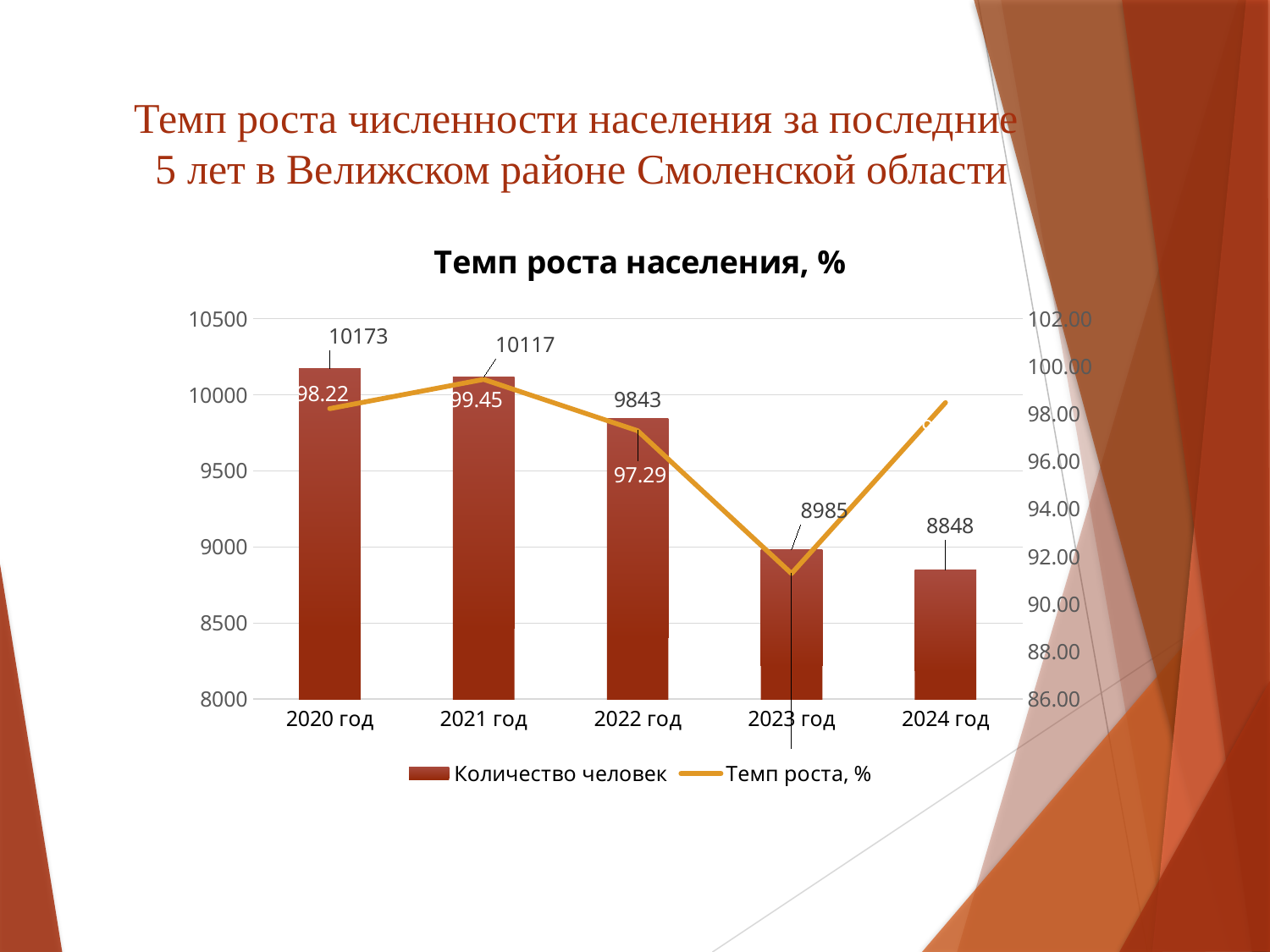
Does Количество человек rise or fall from 2020 год to 2024 год? fall Which year has the lowest value of Количество человек? 2024 год How many years are shown on the x axis? 5 What is the value of Количество человек for 2020 год? 10173 What is the value of Темп роста, % for 2022 год? 97.29 Is the value of Темп роста, % for 2023 год greater or less than 94.00? less What is the value of Темп роста, % for 2021 год? 99.45 Which year has the highest value of Количество человек? 2020 год Which is larger, Количество человек for 2022 год or for 2023 год? 2022 год What is the value of Количество человек for 2024 год? 8848 What is the difference in Количество человек between 2020 год and 2024 год? 1325 How many series does the legend list? 2